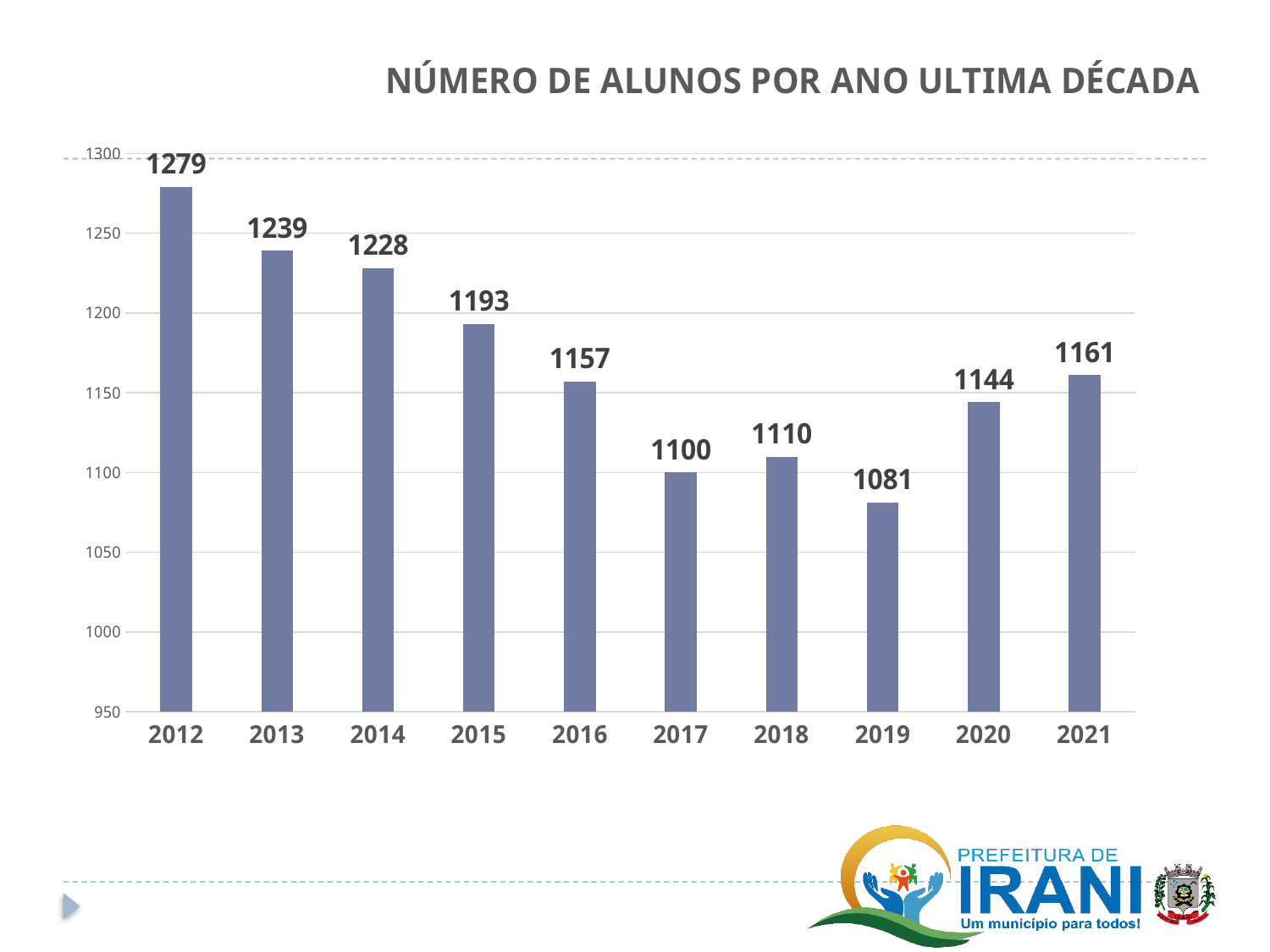
What is the number of students shown for 2021? 1161 What kind of chart is shown on the slide? bar chart What is the number of students shown for 2019? 1081 How many years are shown on the chart? 10 Which year has the highest number of students? 2012 What is the difference between the number of students in 2021 and in 2020? 17 What is the number of students shown for 2012? 1279 Is the value for 2015 greater or less than 1200? less What is the title of the chart? NÚMERO DE ALUNOS POR ANO ULTIMA DÉCADA Which year has more students, 2016 or 2018? 2016 Which year has the lowest number of students? 2019 What is the difference between the number of students in 2012 and in 2019? 198